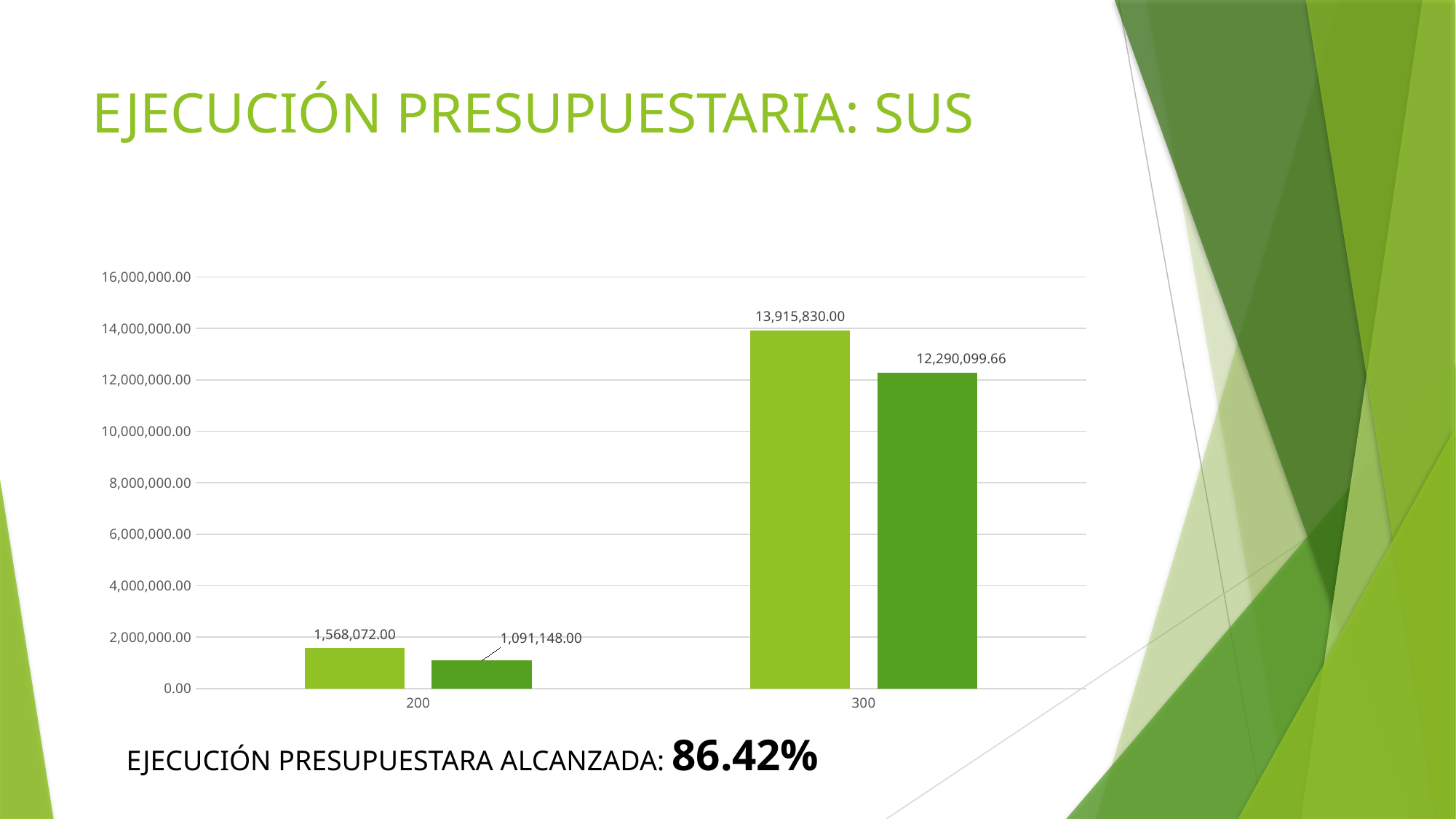
Is the dark green bar for category 300 greater or less than 12,000,000.00? greater What is the difference between the light green and dark green bars for category 300? 1,625,730.34 Which bar has the lowest value in the chart? The dark green bar for 200 (1,091,148.00) What is the value of the light green bar for category 300? 13,915,830.00 What is the value of the light green bar for category 200? 1,568,072.00 What is the value of the dark green bar for category 300? 12,290,099.66 What is the value of the dark green bar for category 200? 1,091,148.00 What is the difference between the light green and dark green bars for category 200? 476,924.00 Which is larger: the light green bar for 200 or the dark green bar for 300? The dark green bar for 300 What type of chart is shown on the slide? Bar chart Which bar has the highest value in the chart? The light green bar for 300 (13,915,830.00) How many categories are shown on the x axis? 2